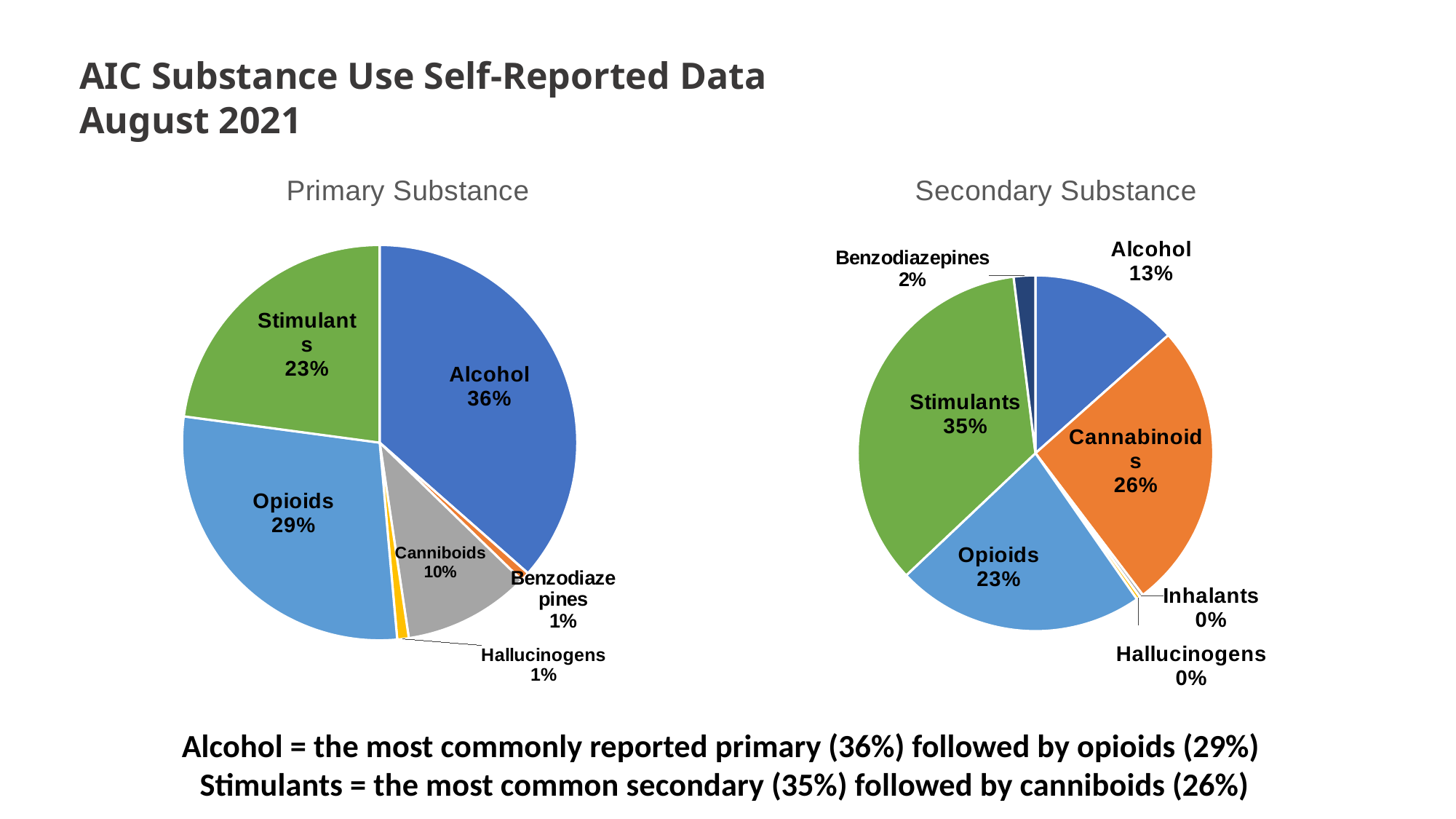
How many labelled categories does the Secondary Substance chart show? 7 In the Primary Substance chart, what share is Opioids? 29% In the Secondary Substance chart, what share is Cannabinoids? 26% In the Secondary Substance chart, which substance has the largest share? Stimulants What is the title of the chart on the left? Primary Substance In the Primary Substance chart, which substance has the largest share? Alcohol In the Secondary Substance chart, what share is Benzodiazepines? 2% What type of chart is the Primary Substance chart? Pie chart In the Secondary Substance chart, what is the difference between the Stimulants and Opioids shares? 12% In the Primary Substance chart, what is the difference between the Alcohol and Stimulants shares? 13% In the Secondary Substance chart, which is larger, Alcohol or Cannabinoids? Cannabinoids In the Primary Substance chart, what share is Alcohol? 36%